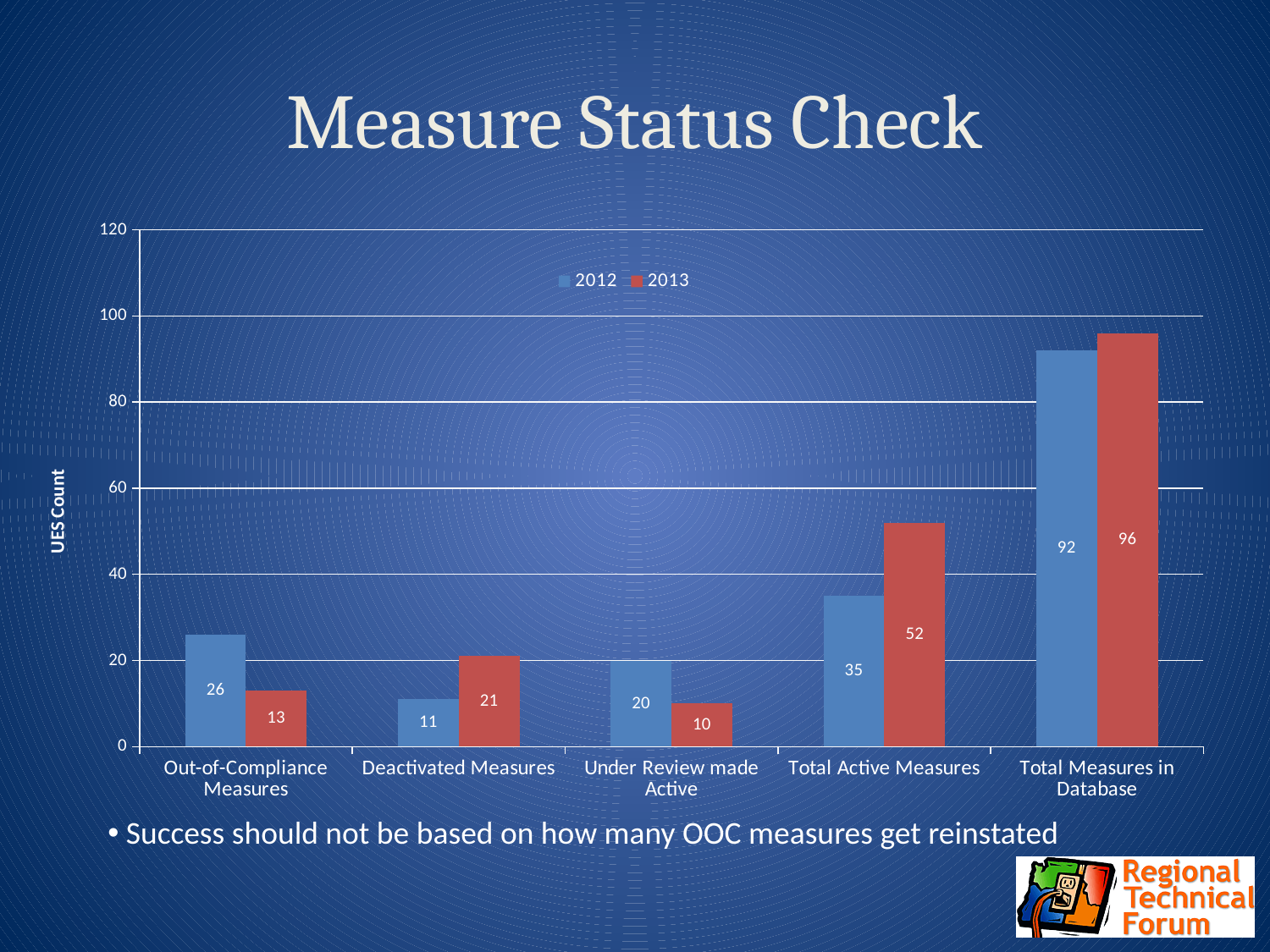
What is the difference between the 2013 and 2012 values for Total Active Measures? 17 What is the difference between the 2012 and 2013 values for Out-of-Compliance Measures? 13 Which is larger for Deactivated Measures, the 2012 value or the 2013 value? 2013 What is the 2013 value for Deactivated Measures? 21 What is the 2012 value for Out-of-Compliance Measures? 26 Is the 2012 value for Total Measures in Database greater or less than 80? greater What is the 2013 value for Total Active Measures? 52 How many series does the legend list? 2 Which category has the lowest 2013 value? Under Review made Active Which category has the highest 2013 value? Total Measures in Database How many categories are shown on the x axis? 5 What kind of chart is shown on the slide? bar chart